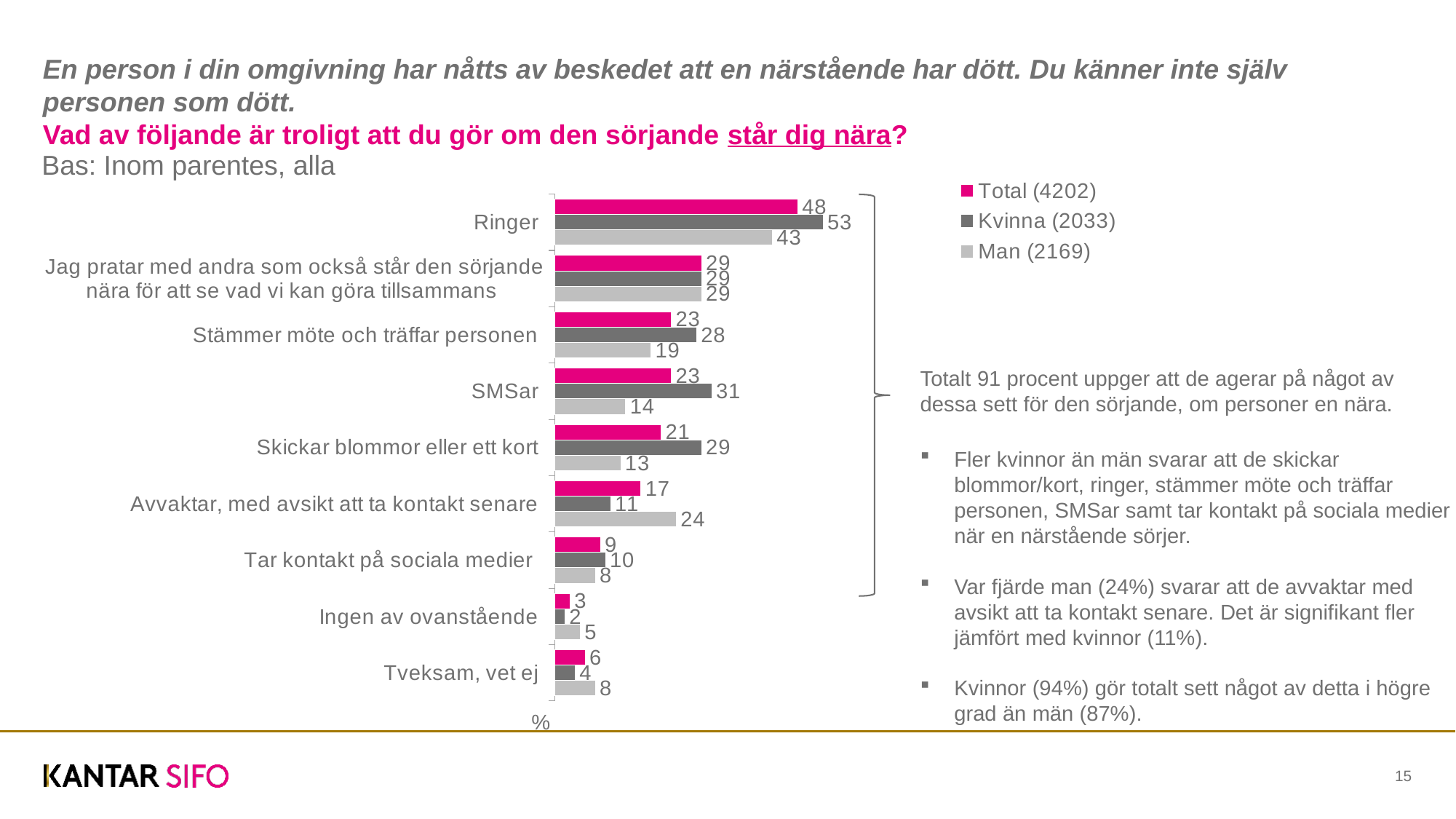
What is the difference between the Kvinna (2033) and Man (2169) values for "Skickar blommor eller ett kort"? 16 How many series does the legend list? 3 Which series is shown in pink on the chart? Total (4202) What is the Man (2169) value for "Avvaktar, med avsikt att ta kontakt senare"? 24 How many categories are shown on the chart? 9 Which category has the lowest Kvinna (2033) value? Ingen av ovanstående Which category has the highest Total (4202) value? Ringer For "Stämmer möte och träffar personen", which is larger: the Kvinna (2033) value or the Man (2169) value? Kvinna (2033) What is the Man (2169) value for "Tveksam, vet ej"? 8 What is the Kvinna (2033) value for "SMSar"? 31 What kind of chart is shown on the slide? Bar chart What is the Total (4202) value for "Ringer"? 48